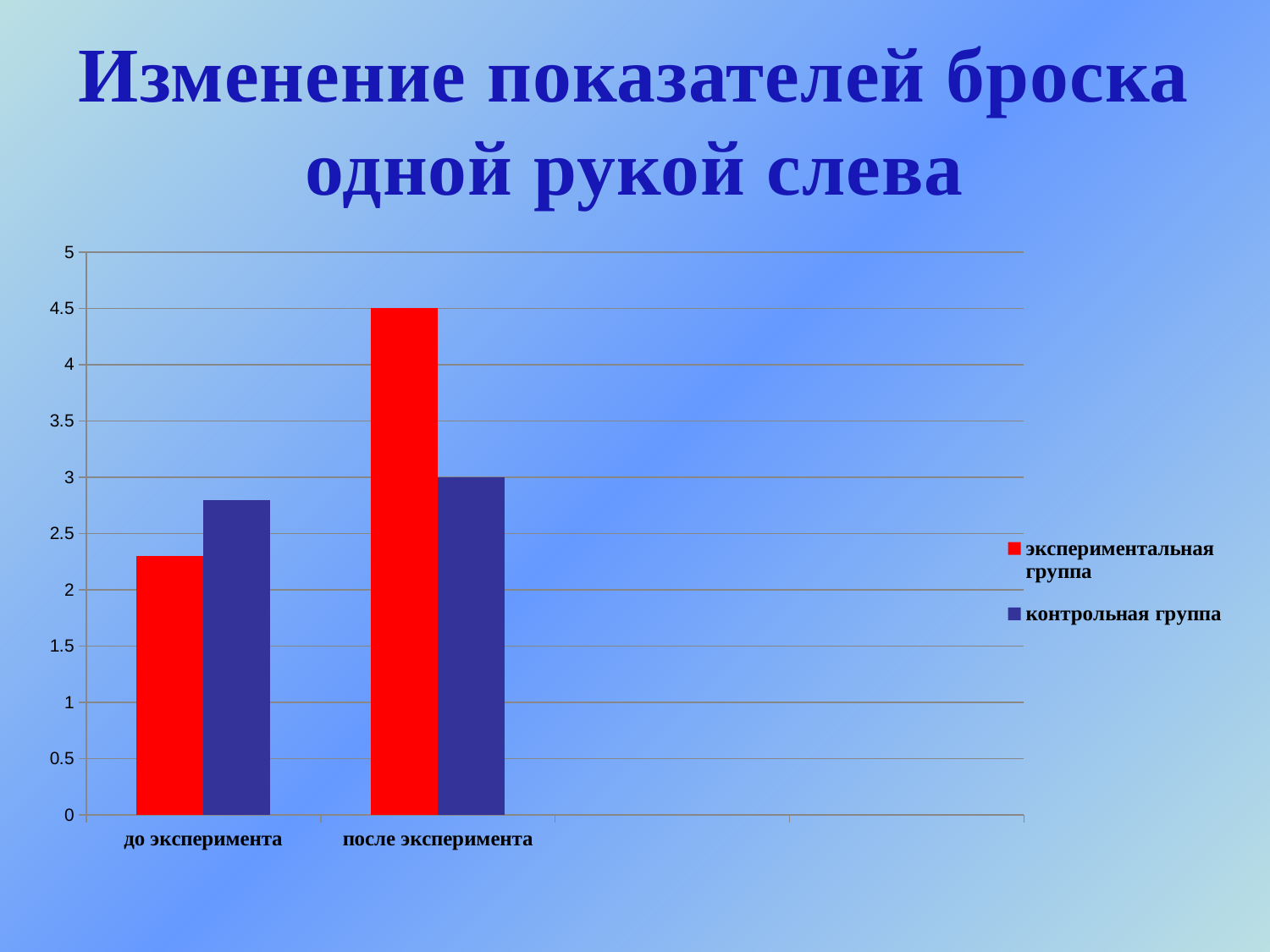
Is the value for контрольная группа до эксперимента greater or less than 2.5? greater How many categories are shown on the x axis? 2 What is the value for контрольная группа после эксперимента? 3 What is the value for экспериментальная группа после эксперимента? 4.5 What is the difference between экспериментальная группа and контрольная группа после эксперимента? 1.5 Which bar is the highest in the chart? экспериментальная группа, после эксперимента После эксперимента, which group has the larger value: экспериментальная группа or контрольная группа? экспериментальная группа До эксперимента, which group has the larger value: экспериментальная группа or контрольная группа? контрольная группа Does the value for экспериментальная группа rise or fall from до эксперимента to после эксперимента? rises How many series does the legend list? 2 Is the value for экспериментальная группа до эксперимента greater or less than 2.5? less What kind of chart is shown on the slide? bar chart